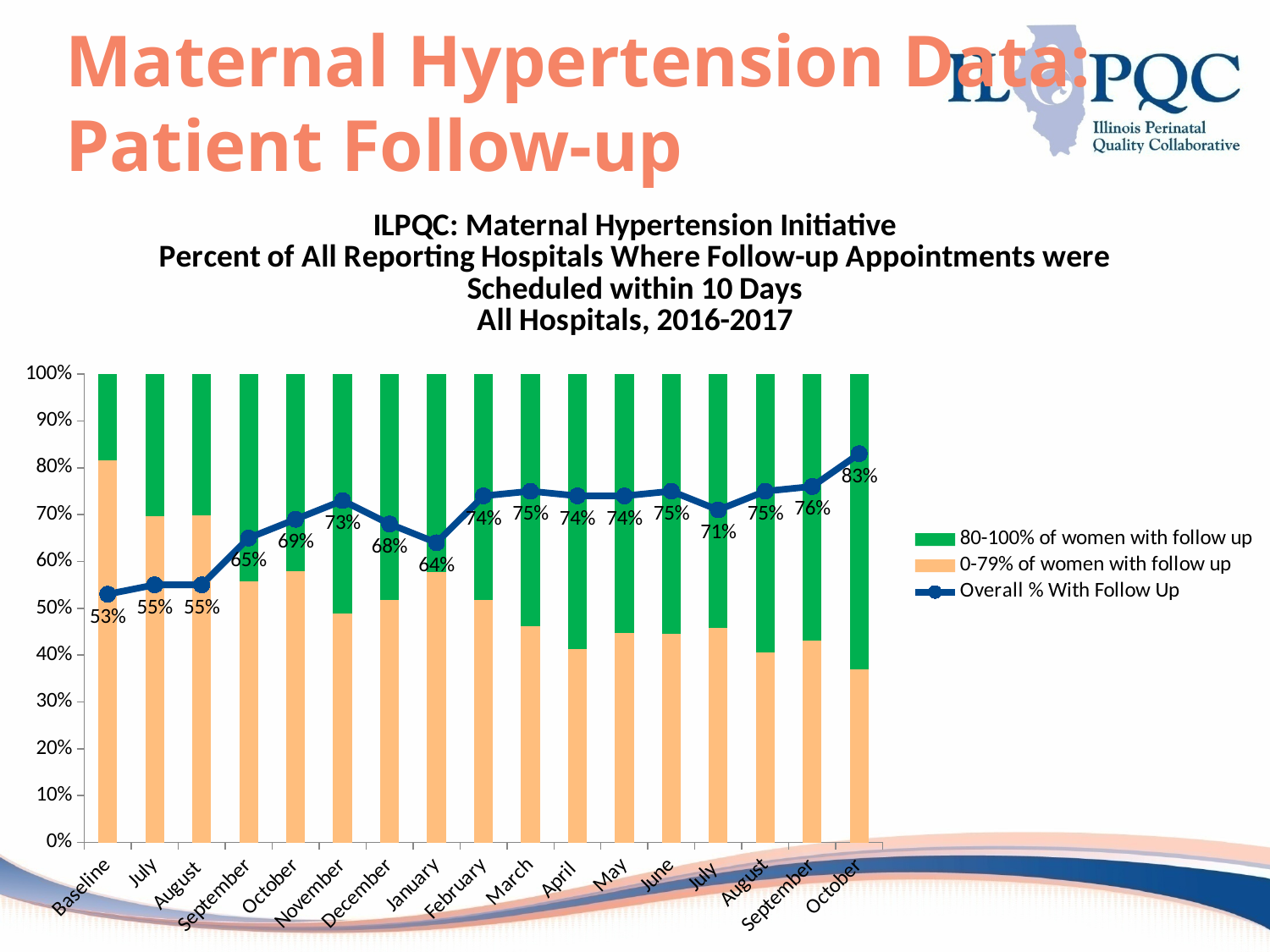
Is the 0-79% of women with follow up bar for Baseline greater or less than 70%? greater What is the Overall % With Follow Up value for January? 64% How many series does the legend list? 3 What is the Overall % With Follow Up value for Baseline? 53% Which category has the lowest Overall % With Follow Up value? Baseline, 53% What kind of chart is this? A combined stacked bar and line chart How many categories are shown on the x axis? 17 What is the Overall % With Follow Up value for November? 73% Which category has the highest Overall % With Follow Up value? October (the last category), 83% What is the difference between the Overall % With Follow Up value for the final October and for Baseline? 30 percentage points Which has a higher Overall % With Follow Up value, November or December? November Does the Overall % With Follow Up line generally rise or fall from Baseline to the final October? Rise